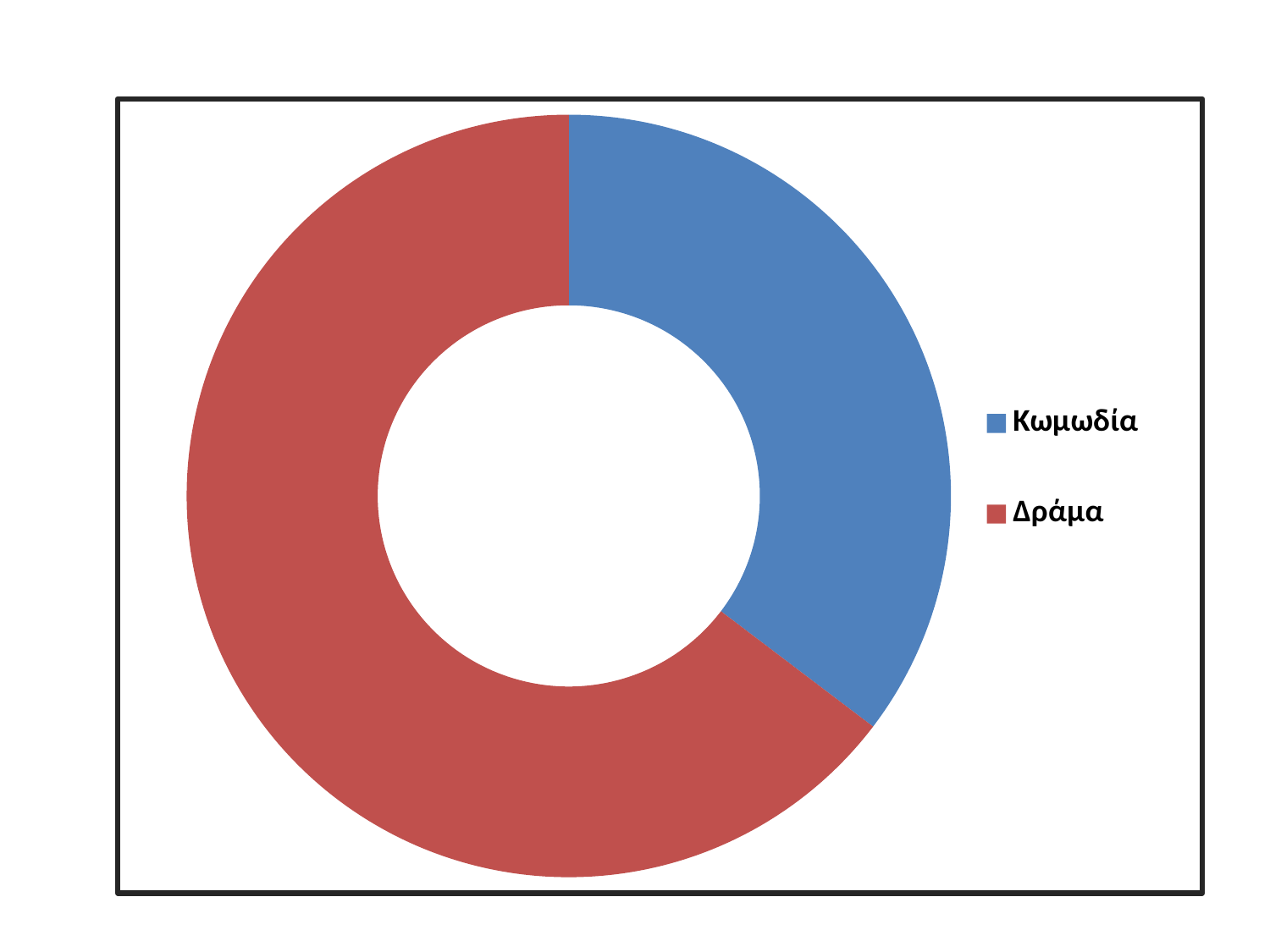
Which is larger, the share for Κωμωδία or the share for Δράμα? Δράμα What colour represents Κωμωδία in the chart? Blue Does Δράμα take up more or less than half of the chart? More Which category has the largest share of the chart? Δράμα How many categories does the chart show? 2 What are the two entries listed in the legend? Κωμωδία and Δράμα Which category has the smallest share of the chart? Κωμωδία What kind of chart is shown on the slide? Doughnut chart